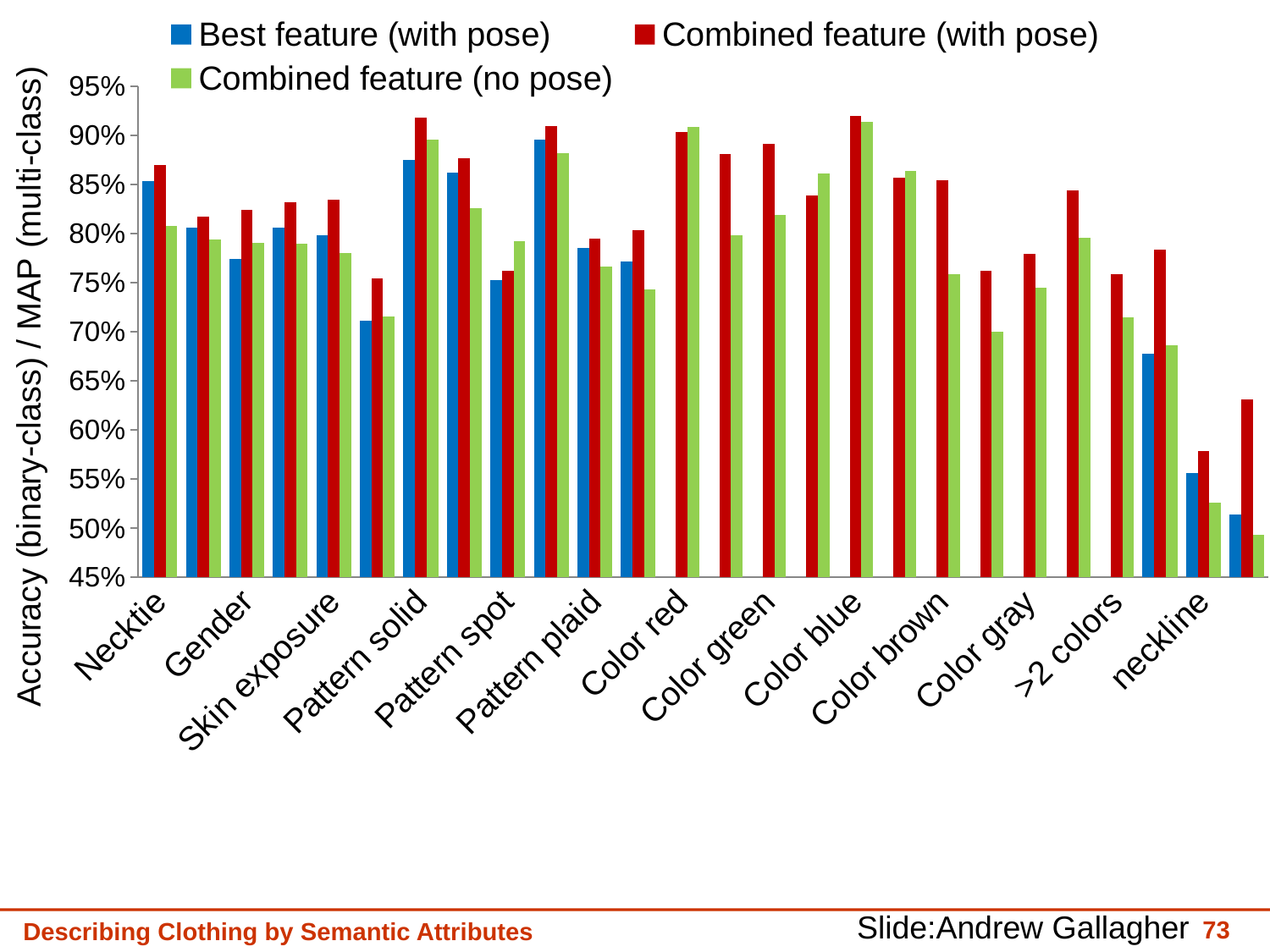
How many series does the legend list? 3 For Color brown, which is larger: the Combined feature (with pose) value or the Combined feature (no pose) value? Combined feature (with pose) Is the Combined feature (no pose) value for Color brown greater or less than 80%? less What kind of chart is shown on the slide? Bar chart Is the Combined feature (with pose) value for neckline greater or less than 60%? less Is the Combined feature (with pose) value for Necktie greater or less than 85%? greater Which labeled category has the lowest Combined feature (with pose) value? neckline Which series is shown in red in the legend? Combined feature (with pose) For Necktie, which is larger: the Best feature (with pose) value or the Combined feature (with pose) value? Combined feature (with pose) What is the label of the vertical axis? Accuracy (binary-class) / MAP (multi-class)